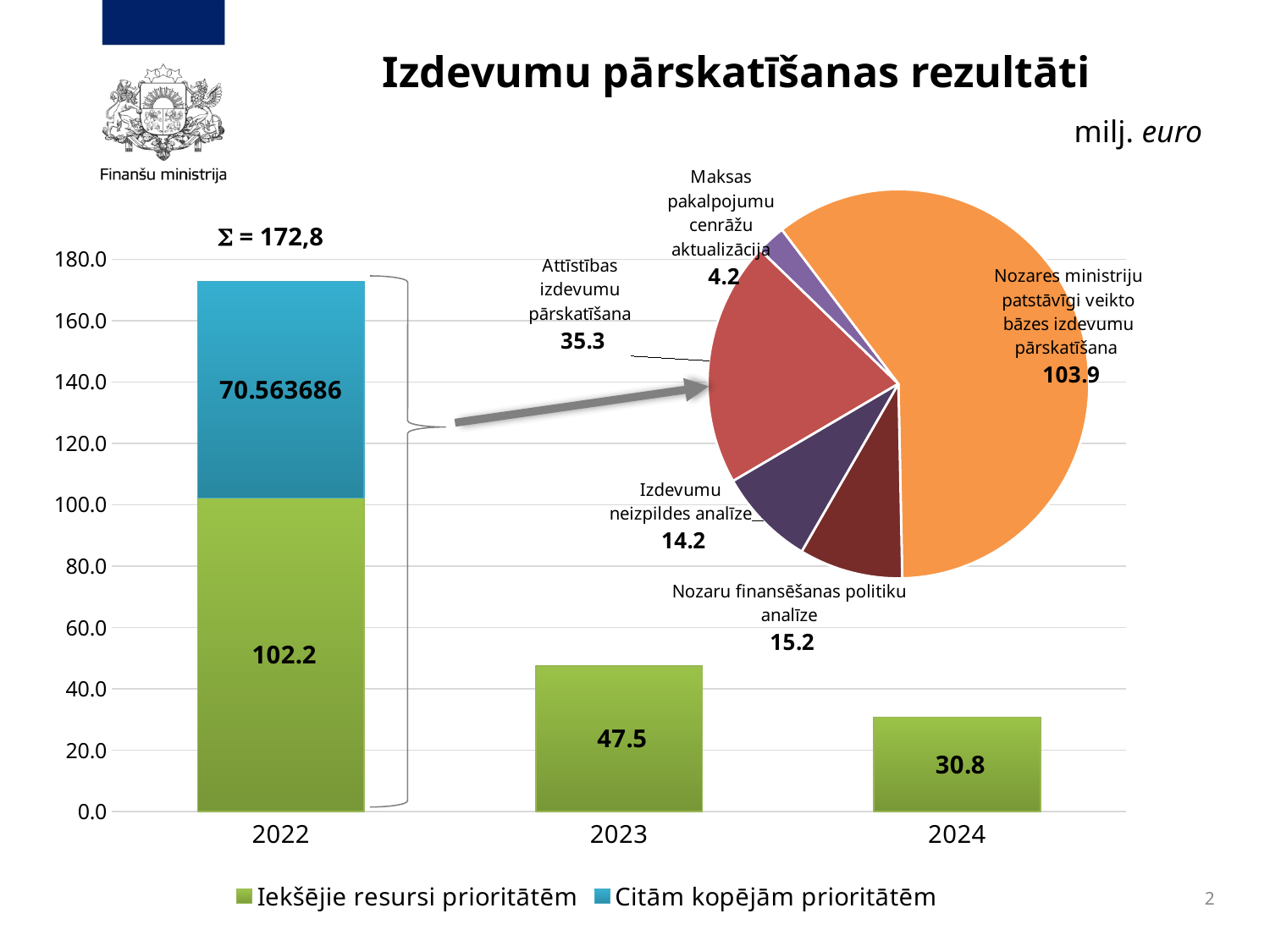
On the bar chart, how many series does the legend list? 2 On the bar chart, what is the difference between the 2023 value (47.5) and the 2024 value (30.8)? 16.7 On the pie chart, which is larger: Izdevumu neizpildes analīze or Nozaru finansēšanas politiku analīze? Nozaru finansēšanas politiku analīze On the bar chart, what is the value of Iekšējie resursi prioritātēm for 2022? 102.2 On the bar chart, what is the total of the stacked bar for 2022, as labelled above it? 172,8 On the pie chart, how many slices are there? 5 On the pie chart, what is the value for Nozares ministriju patstāvīgi veikto bāzes izdevumu pārskatīšana? 103.9 On the pie chart, which category has the smallest slice? Maksas pakalpojumu cenrāžu aktualizācija On the bar chart, what is the value shown for 2024? 30.8 On the bar chart, what is the value of Citām kopējām prioritātēm for 2022? 70.563686 What unit is stated for the values on the slide? milj. euro On the bar chart, do the Iekšējie resursi prioritātēm values rise or fall from 2022 to 2024? fall